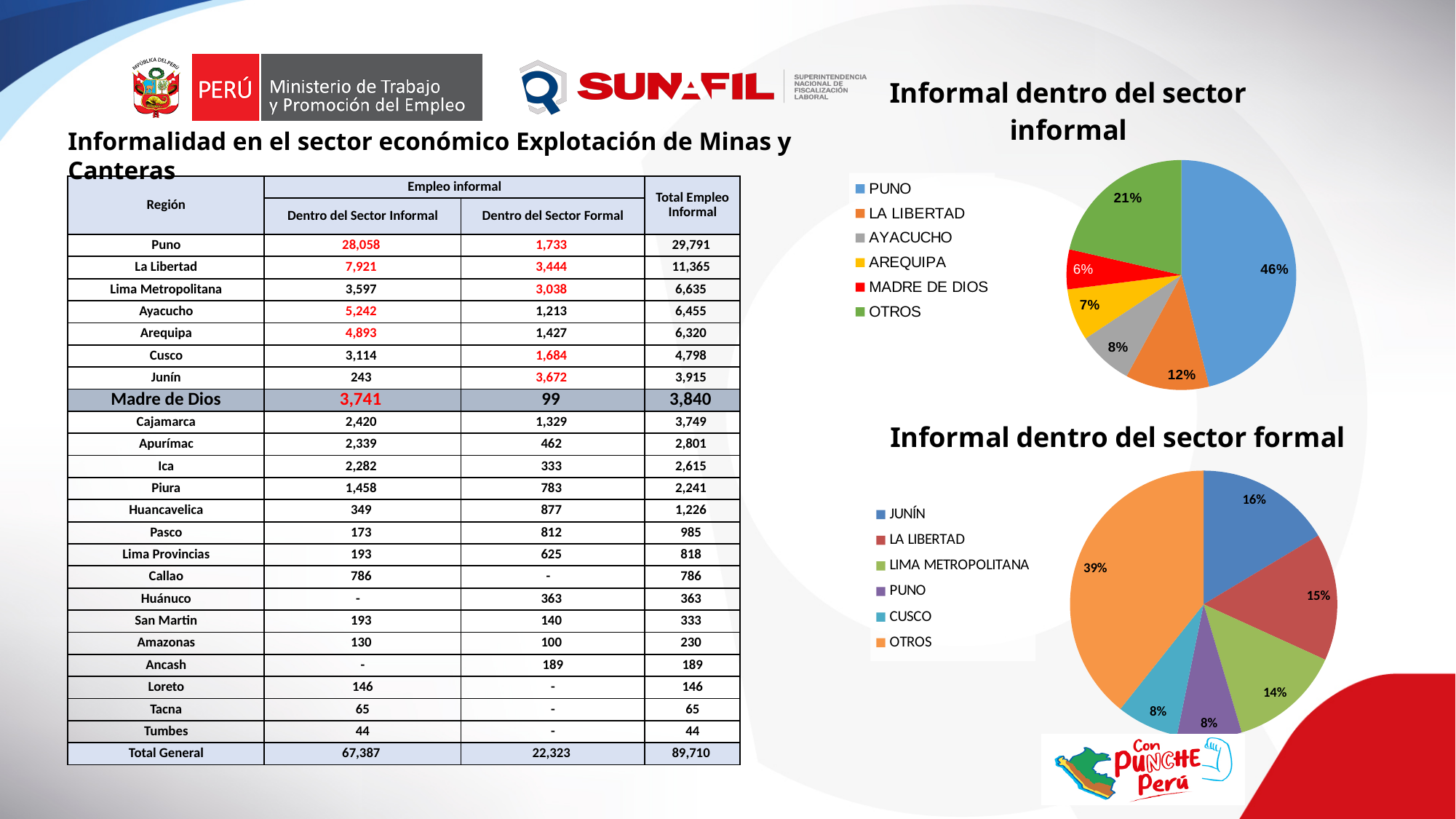
In the 'Informal dentro del sector informal' chart, how many categories does the legend list? 6 What type of chart is 'Informal dentro del sector formal'? Pie chart In the 'Informal dentro del sector formal' chart, what share does LIMA METROPOLITANA have? 14% In the 'Informal dentro del sector formal' chart, what share does JUNÍN have? 16% In the 'Informal dentro del sector informal' chart, which category has the smallest slice? MADRE DE DIOS In the 'Informal dentro del sector formal' chart, which is larger, the share of LA LIBERTAD or the share of PUNO? LA LIBERTAD In the 'Informal dentro del sector informal' chart, what share does PUNO have? 46% In the 'Informal dentro del sector informal' chart, which named region has the largest slice? PUNO In the 'Informal dentro del sector informal' chart, what share does LA LIBERTAD have? 12% In the 'Informal dentro del sector formal' chart, what share does OTROS have? 39% In the 'Informal dentro del sector informal' chart, what share does MADRE DE DIOS have? 6% In the 'Informal dentro del sector formal' chart, what is the difference between the shares of OTROS and JUNÍN? 23 percentage points